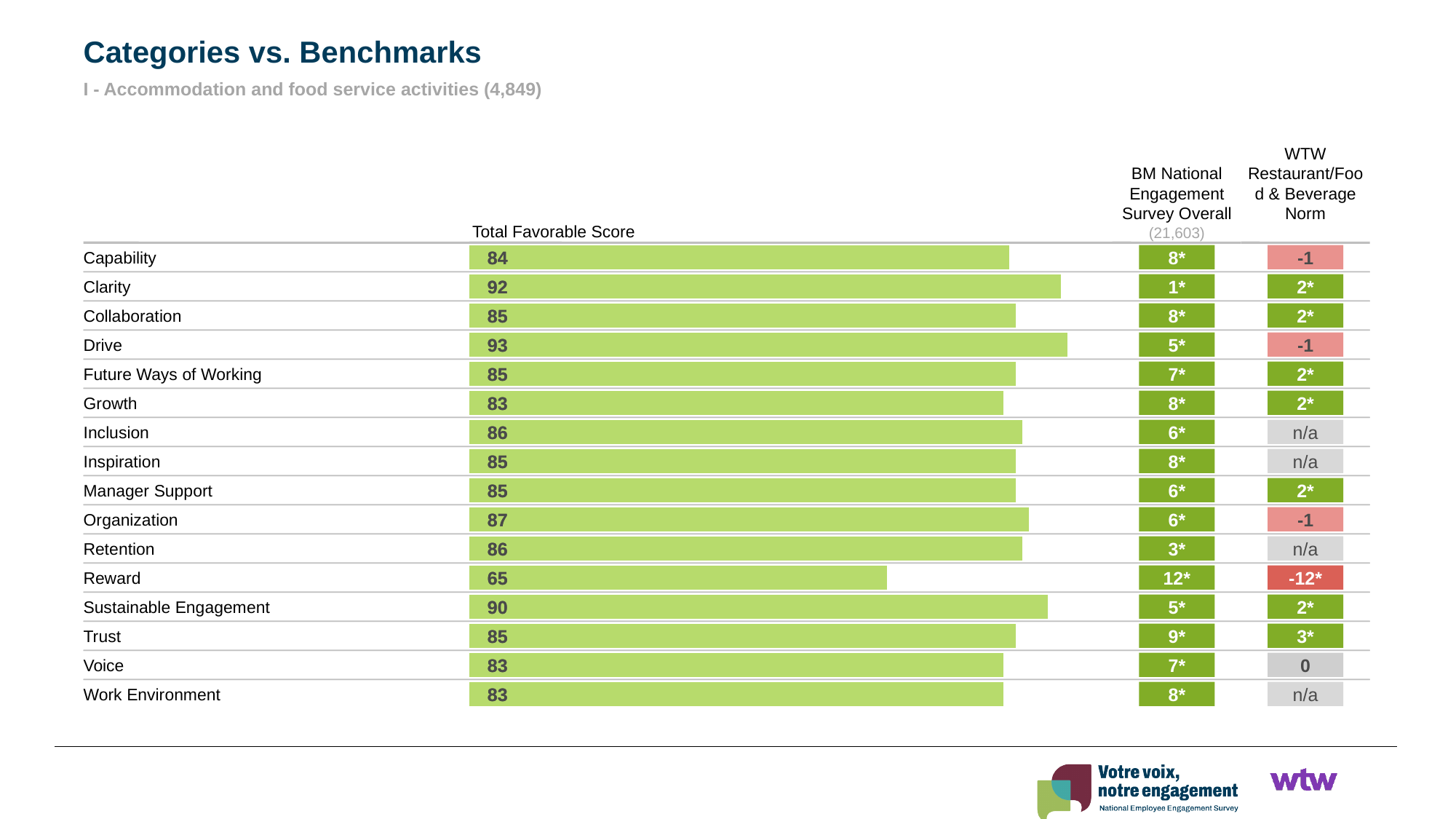
Which category has the highest Total Favorable Score? Drive What is the value shown for Trust in the WTW Restaurant/Food & Beverage Norm column? 3* What is the title of the slide? Categories vs. Benchmarks What is the Total Favorable Score for Growth? 83 What is the Total Favorable Score for Clarity? 92 What is the difference between the Total Favorable Scores for Drive and Reward? 28 How many categories are shown in the chart? 16 What is the Total Favorable Score for Reward? 65 What is the value shown for Reward in the BM National Engagement Survey Overall column? 12* Which has a higher Total Favorable Score, Sustainable Engagement or Organization? Sustainable Engagement What kind of chart is used to show the Total Favorable Scores? Bar chart Which category has the lowest Total Favorable Score? Reward